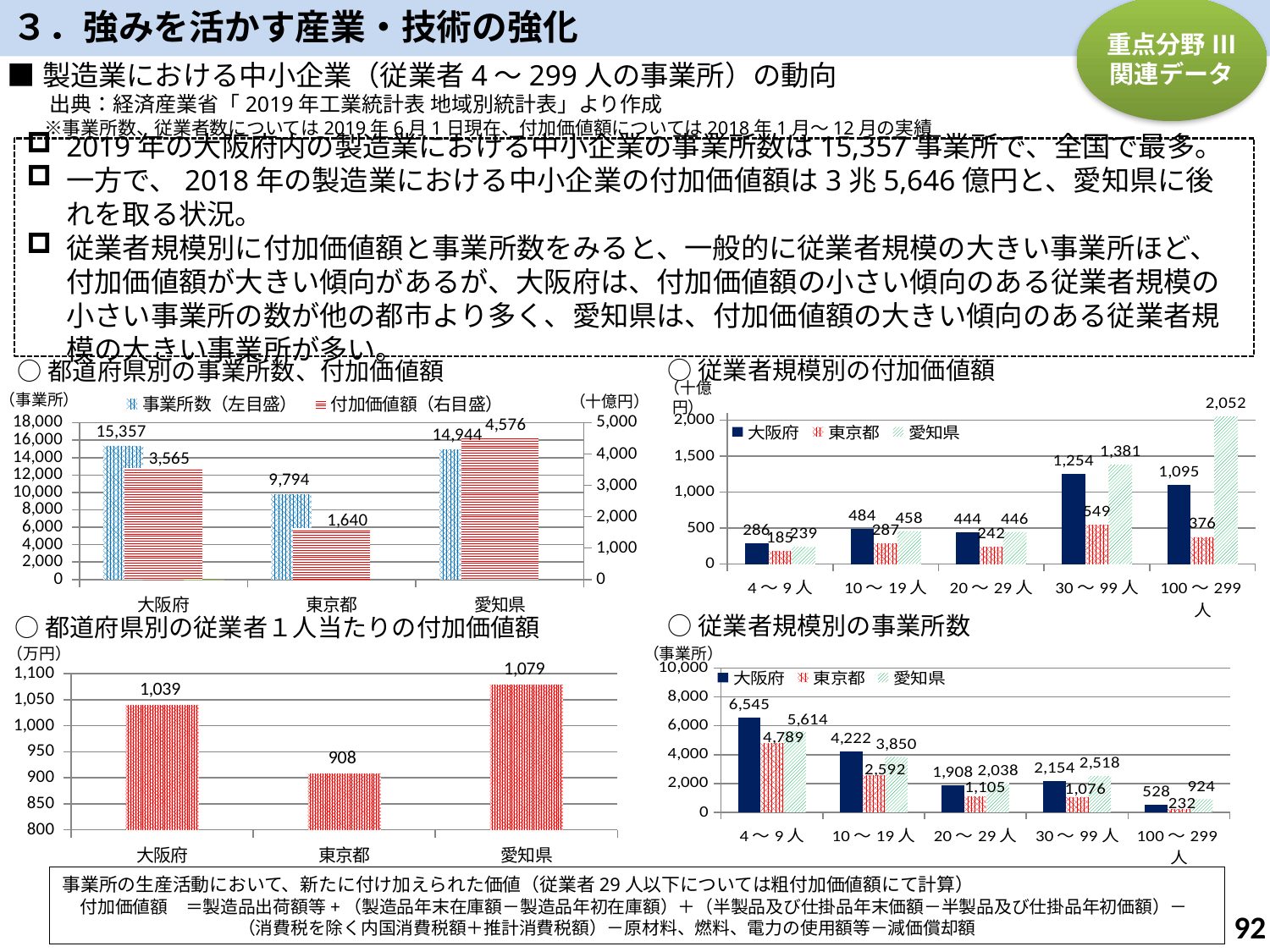
In the chart titled 都道府県別の事業所数、付加価値額, what is the 事業所数 value for 大阪府? 15,357 In the chart titled 従業者規模別の事業所数, what is the value for 大阪府 in the 4～9人 category? 6,545 In the chart titled 都道府県別の従業者1人当たりの付加価値額, which prefecture has the lowest value? 東京都 In the chart titled 都道府県別の事業所数、付加価値額, what is the difference in 事業所数 between 大阪府 and 東京都? 5,563 What kind of chart is the one titled 都道府県別の従業者1人当たりの付加価値額? bar chart In the chart titled 都道府県別の従業者1人当たりの付加価値額, what is the value for 東京都? 908 In the chart titled 従業者規模別の事業所数, what is the difference between 愛知県 and 東京都 in the 100～299人 category? 692 In the chart titled 従業者規模別の付加価値額, what is the value for 愛知県 in the 100～299人 category? 2,052 In the chart titled 従業者規模別の事業所数, how many employee-size categories are shown on the x axis? 5 In the chart titled 従業者規模別の付加価値額, which is larger in the 30～99人 category, 大阪府 or 愛知県? 愛知県 In the chart titled 都道府県別の事業所数、付加価値額, which prefecture has the highest 付加価値額? 愛知県 In the chart titled 従業者規模別の付加価値額, how many series does the legend list? 3